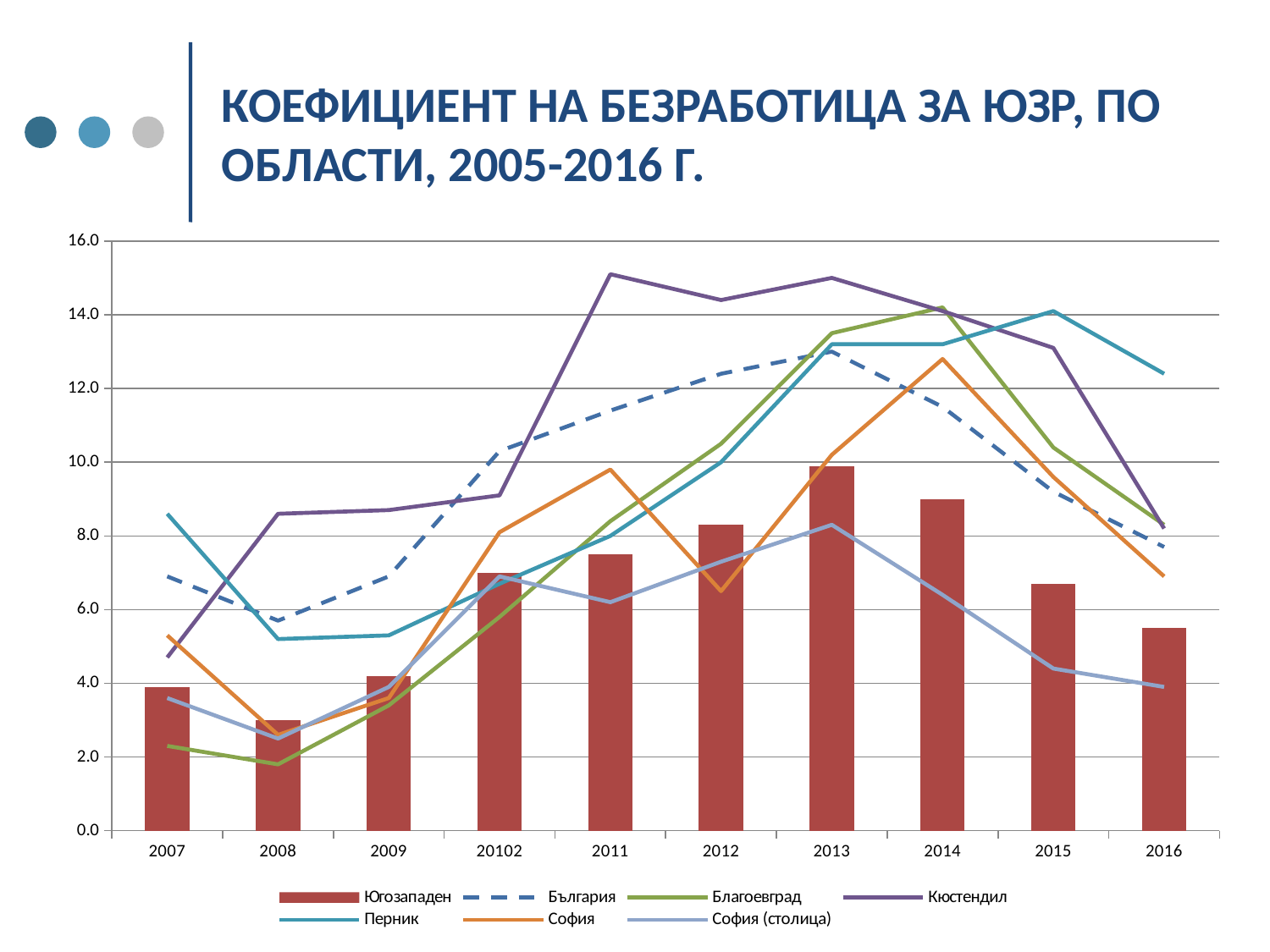
In which year is the bar for Югозападен the highest? 2013 In which year is the bar for Югозападен the lowest? 2008 How many series does the chart's legend list? 7 Which is larger for Югозападен: the value in 2014 or the value in 2015? 2014 Which series is drawn as bars in the chart? Югозападен Is the value for Югозападен in 2013 greater or less than 8.0? greater Is the value for София (столица) in 2016 greater or less than 6.0? less How many years are shown on the x axis of the chart? 10 Which series is drawn with a dashed line in the chart? България What kind of chart is shown on the slide? A combination chart with bars and lines Is the value for Кюстендил in 2011 greater or less than 14.0? greater Do the values for Югозападен rise or fall from 2013 to 2016? fall